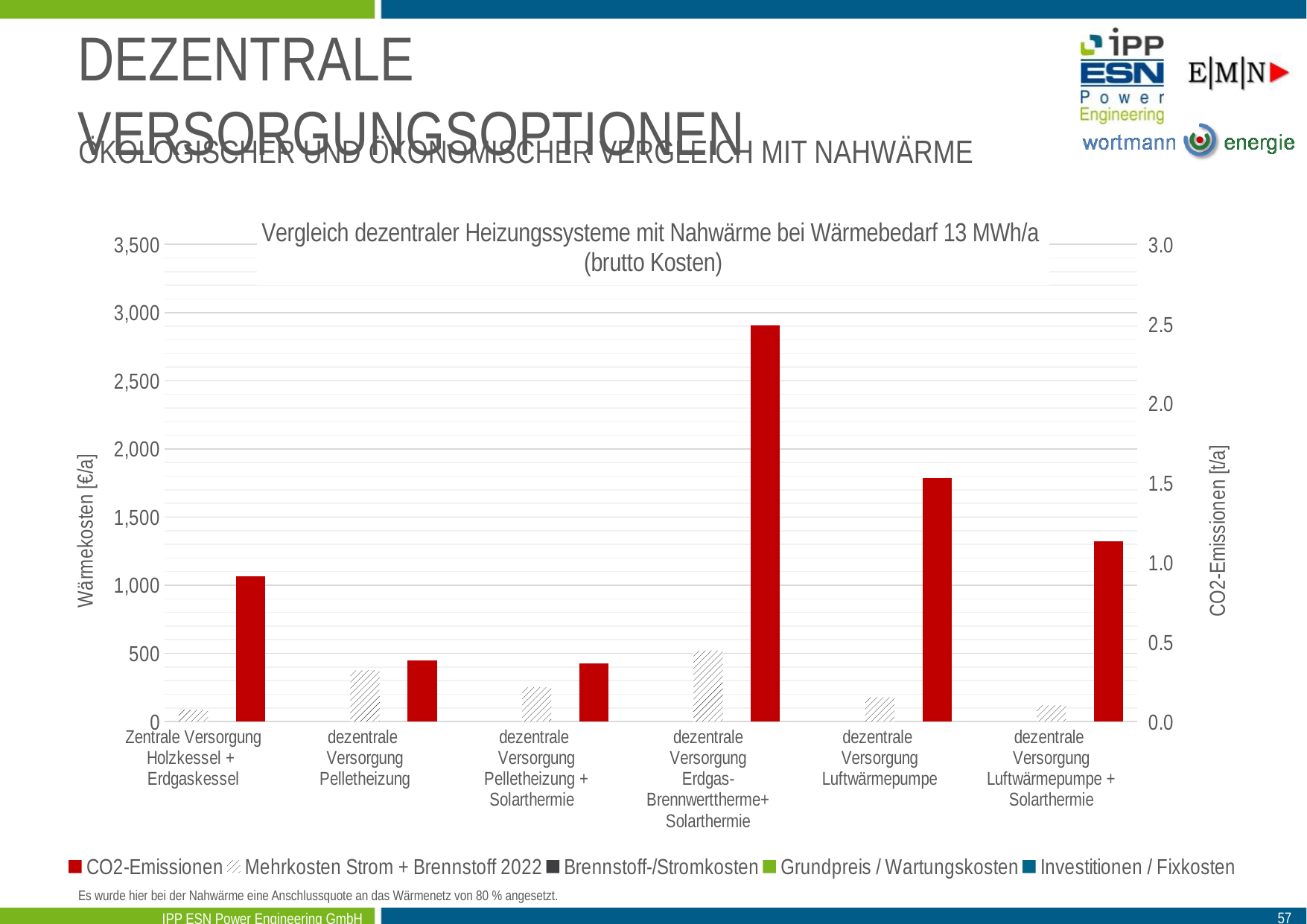
How many series does the legend list? 5 Is the CO2-Emissionen value for dezentrale Versorgung Erdgas-Brennwerttherme+Solarthermie greater or less than 2.0? greater Is the CO2-Emissionen value for dezentrale Versorgung Luftwärmepumpe greater or less than 1.0? greater Which has higher CO2-Emissionen: Zentrale Versorgung Holzkessel + Erdgaskessel or dezentrale Versorgung Pelletheizung? Zentrale Versorgung Holzkessel + Erdgaskessel Is the Mehrkosten Strom + Brennstoff 2022 value for dezentrale Versorgung Pelletheizung greater or less than 500? less How many heating system categories are shown along the x axis? 6 What is the label of the right-hand y axis? CO2-Emissionen [t/a] Which has higher CO2-Emissionen: dezentrale Versorgung Luftwärmepumpe or dezentrale Versorgung Luftwärmepumpe + Solarthermie? dezentrale Versorgung Luftwärmepumpe Which category has the highest CO2-Emissionen? dezentrale Versorgung Erdgas-Brennwerttherme+Solarthermie What kind of chart is shown on the slide? bar chart Which category has the highest Mehrkosten Strom + Brennstoff 2022? dezentrale Versorgung Erdgas-Brennwerttherme+Solarthermie